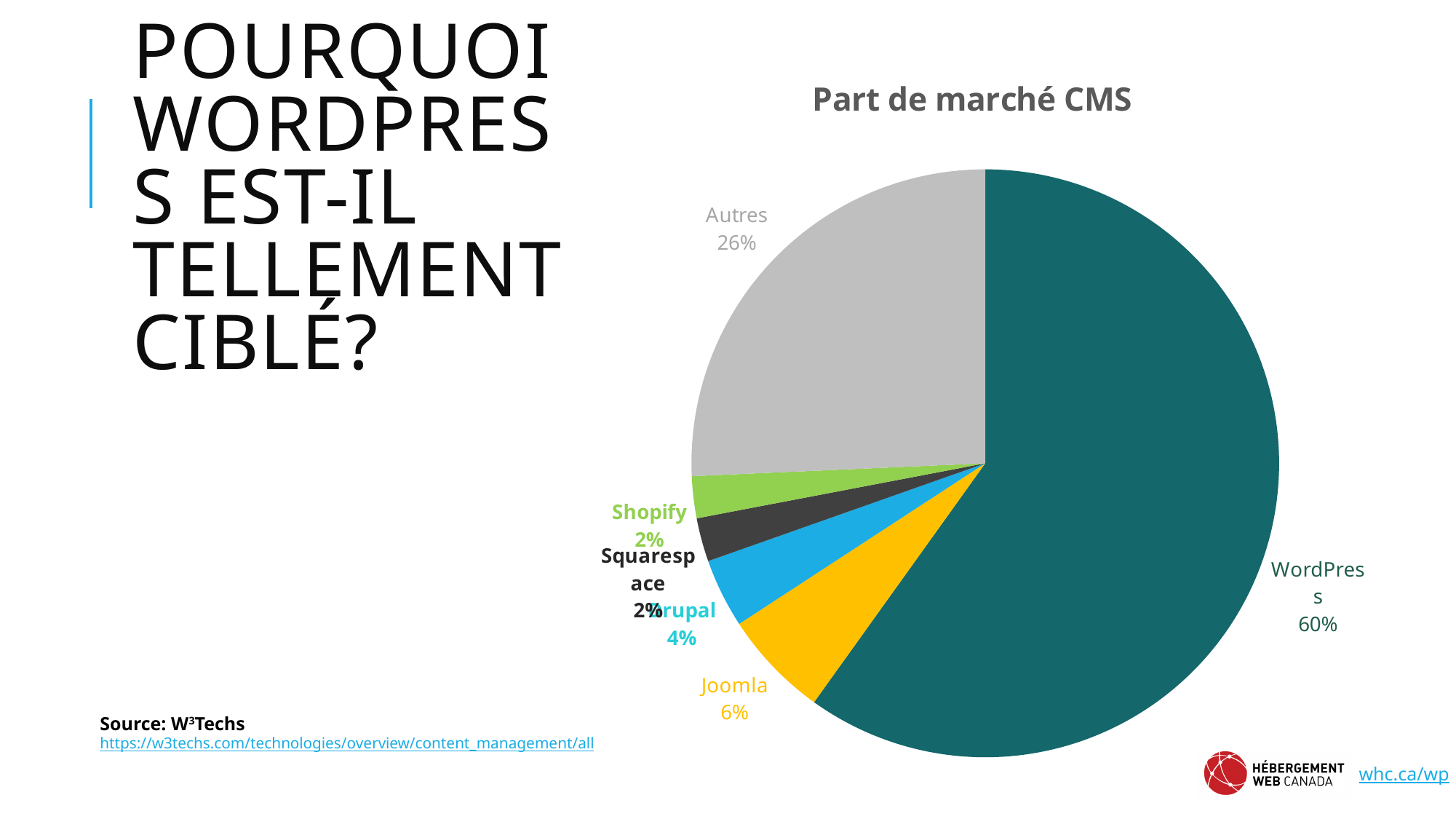
What is the market share shown for WordPress? 60% What kind of chart is shown on the slide? pie chart What is the difference between the WordPress share and the Autres share? 34% What is the market share shown for Autres? 26% What is the market share shown for Shopify? 2% How many slices does the pie chart have? 6 Which CMS has the largest slice of the pie? WordPress What colour is the WordPress slice? dark teal What is the title of the chart? Part de marché CMS Which has a larger share, Joomla or Drupal? Joomla What is the market share shown for Drupal? 4% What is the market share shown for Joomla? 6%